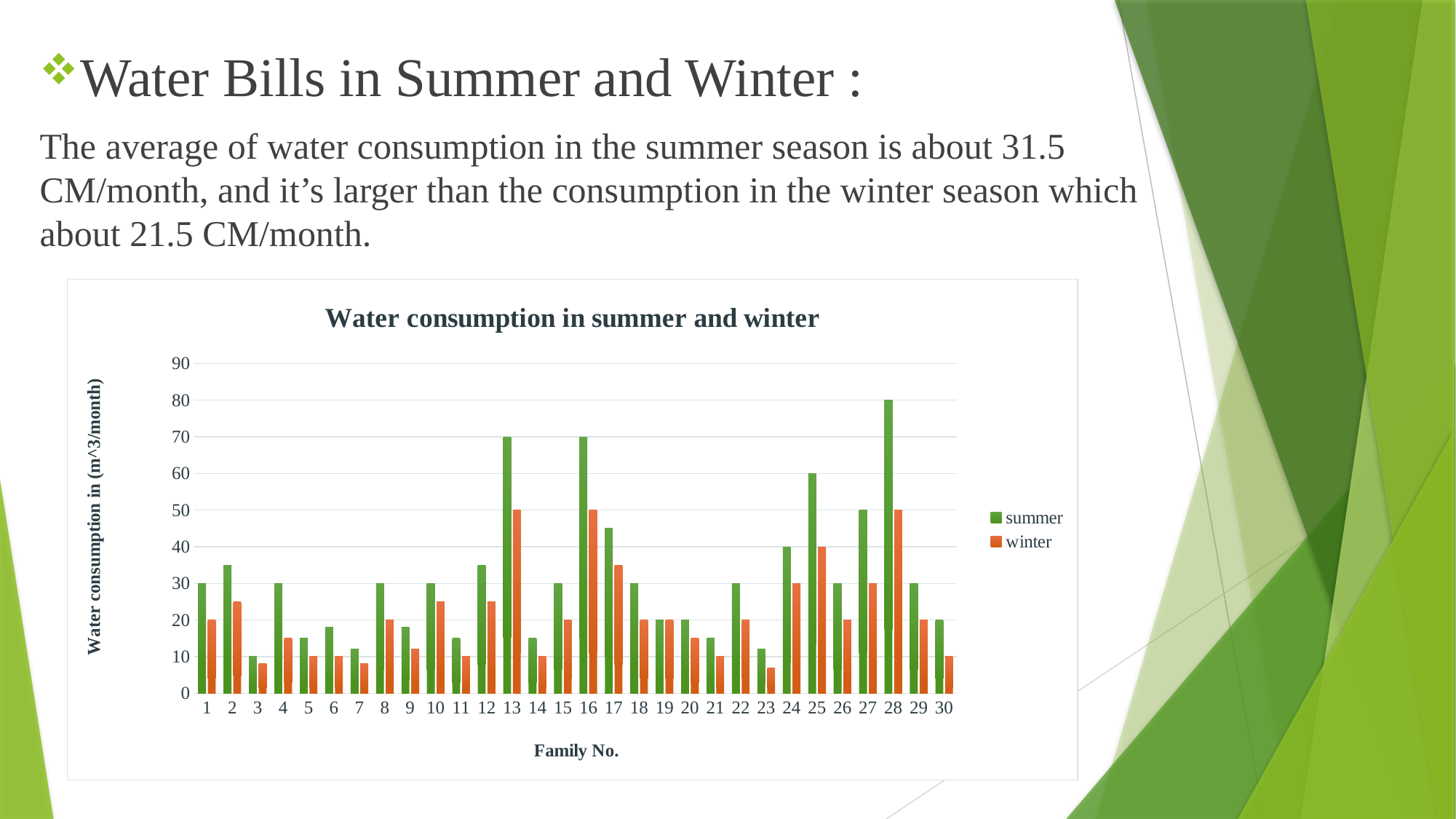
What is the title of the chart? Water consumption in summer and winter What is the summer water consumption for family 13? 70 What kind of chart is shown on the slide? bar chart What is the summer water consumption for family 28? 80 What is the winter water consumption for family 16? 50 Which is larger, the summer consumption of family 25 or family 27? family 25 What is the difference between the summer consumption of family 28 and family 13? 10 Is the summer consumption for family 17 greater or less than 40? greater Which colour represents the winter series in the legend? orange How many series does the legend list? 2 How many families are shown on the x axis? 30 Which family has the highest summer water consumption? 28